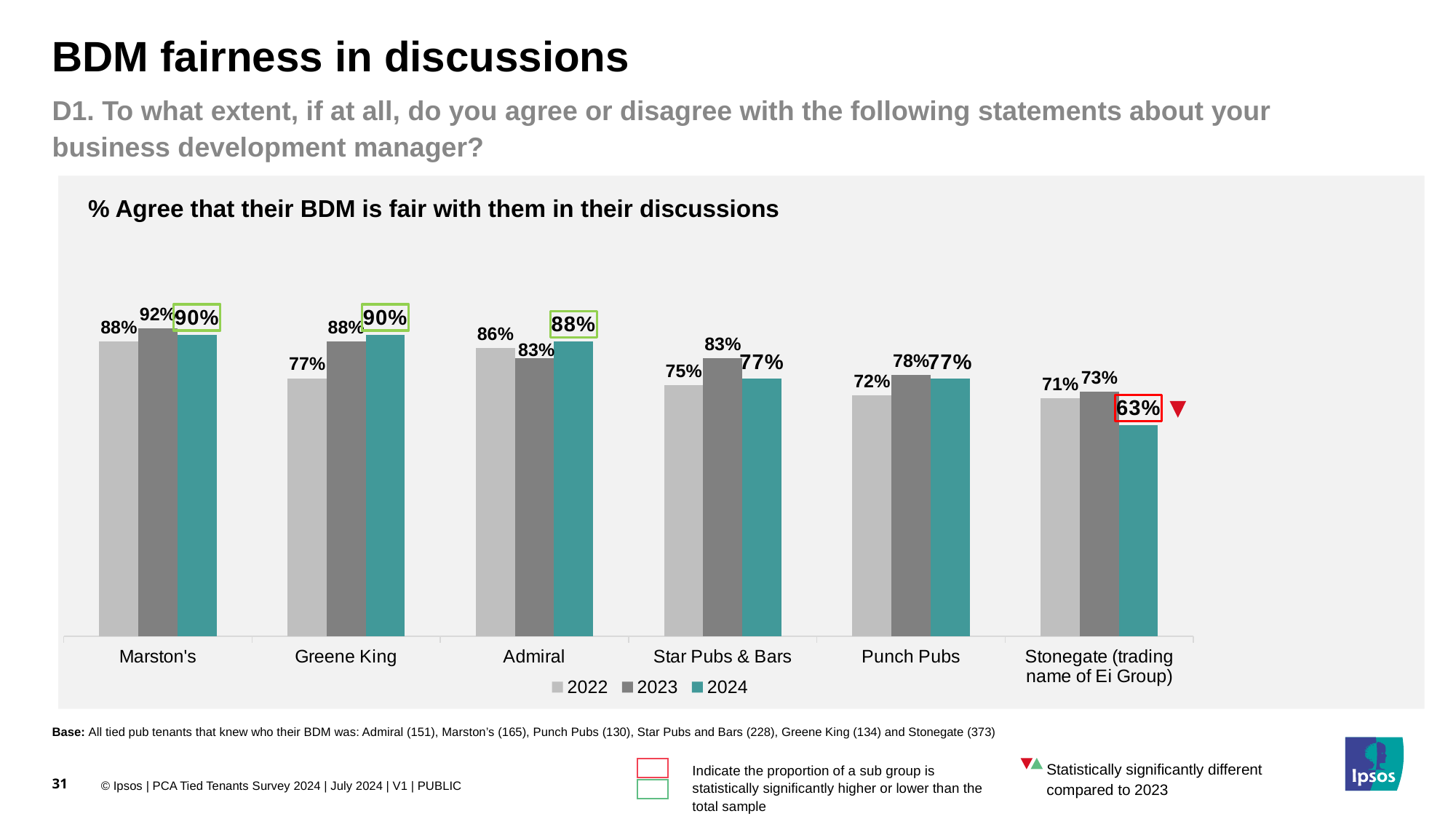
How many pub companies are shown on the x axis? 6 What percentage of Marston's tenants agreed in 2023 that their BDM is fair with them in their discussions? 92% What is the 2024 value for Stonegate (trading name of Ei Group)? 63% What is the title of the chart? % Agree that their BDM is fair with them in their discussions Which is larger for Star Pubs & Bars: the 2023 value or the 2024 value? 2023 What kind of chart is shown on the slide? Bar chart Which pub company has the lowest 2024 value? Stonegate (trading name of Ei Group) What is the difference between Greene King's 2024 and 2022 values? 13 percentage points Which pub company has the highest 2023 value? Marston's How many series does the legend list? 3 What is the 2022 value for Greene King? 77% Did Stonegate's value rise or fall from 2023 to 2024? Fall